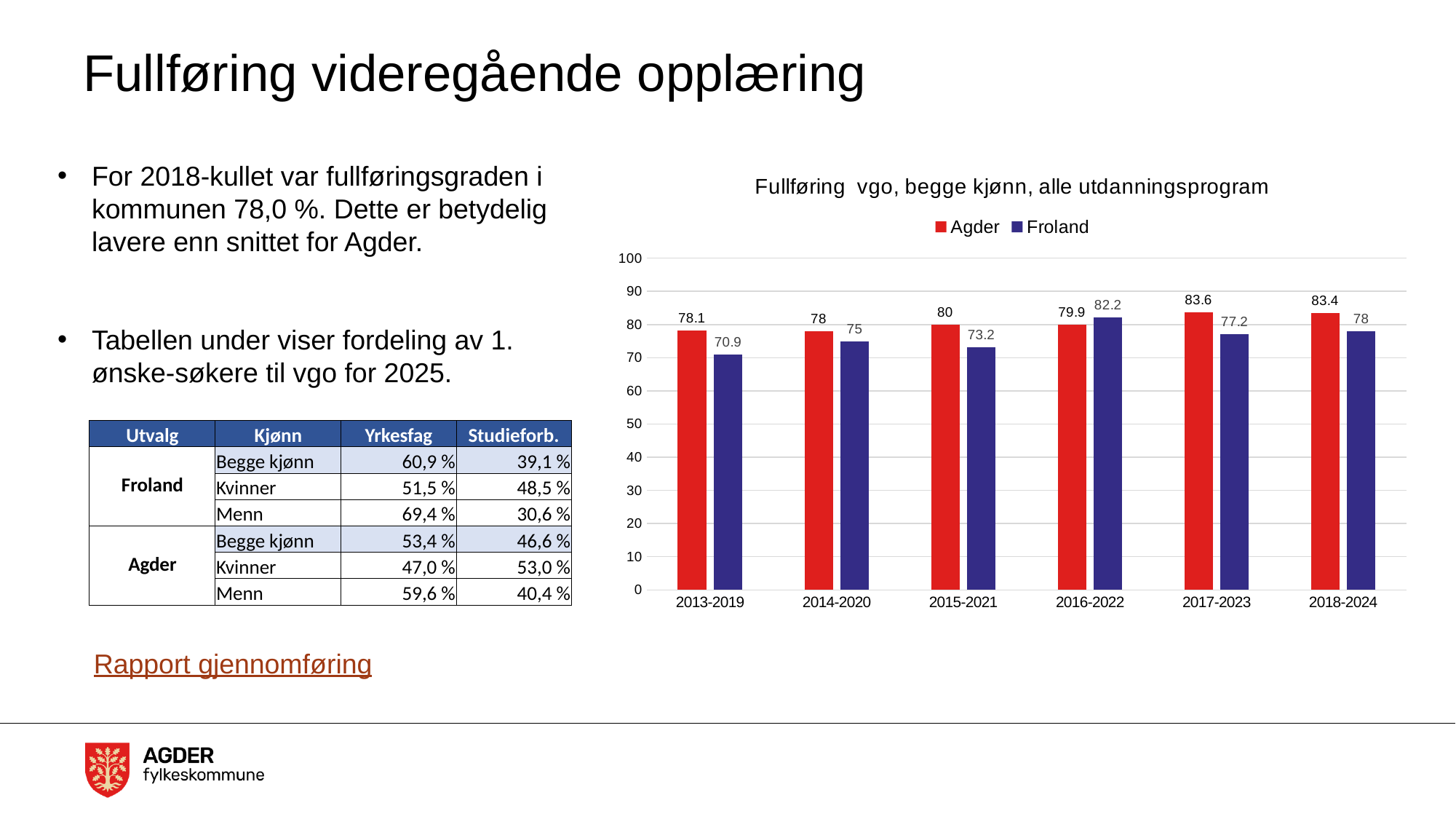
Is the value for Froland in 2015-2021 greater or less than 80? less What is the value for Agder in 2013-2019? 78.1 What is the title of the chart? Fullføring vgo, begge kjønn, alle utdanningsprogram What kind of chart is shown? bar chart What is the value for Froland in 2016-2022? 82.2 In which period is the Agder value highest? 2017-2023 What is the difference between Agder and Froland in 2013-2019? 7.2 How many series does the legend list? 2 How many periods are shown on the x axis? 6 In which period is the Froland value lowest? 2013-2019 What is the value for Froland in 2018-2024? 78 Which is larger in 2016-2022, Agder or Froland? Froland